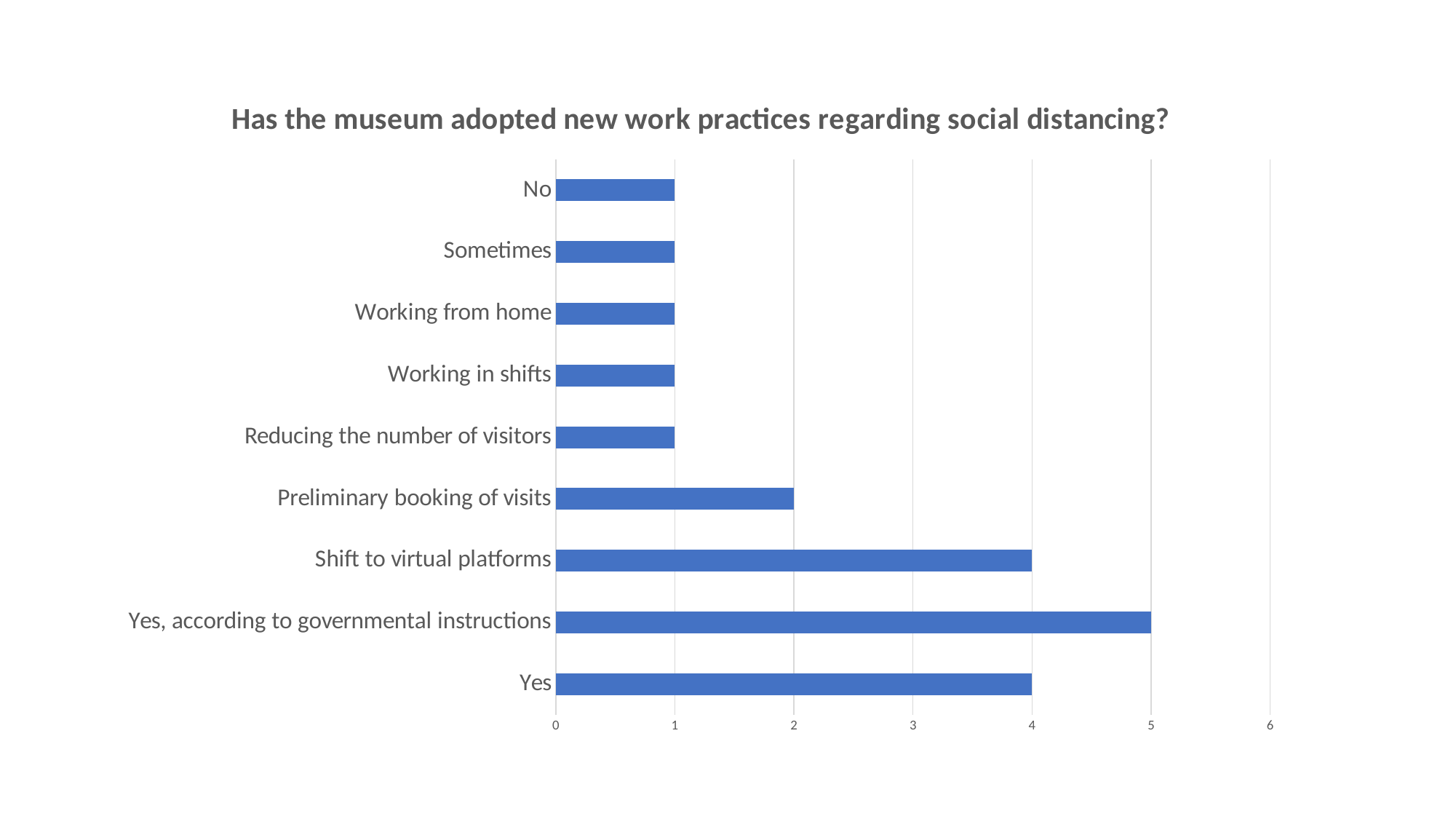
Is the value for "Yes" greater or less than 3? greater What is the value for "Working from home"? 1 What is the value for "Shift to virtual platforms"? 4 Which is larger, the value for "Preliminary booking of visits" or the value for "Reducing the number of visitors"? Preliminary booking of visits What type of chart is shown on the slide? Bar chart How many categories are shown in the chart? 9 What is the difference between the values for "Shift to virtual platforms" and "Preliminary booking of visits"? 2 Which category has the highest value? Yes, according to governmental instructions What is the value for "Yes, according to governmental instructions"? 5 What is the difference between the values for "Yes, according to governmental instructions" and "Yes"? 1 What is the value for "Preliminary booking of visits"? 2 What is the title of the chart? Has the museum adopted new work practices regarding social distancing?